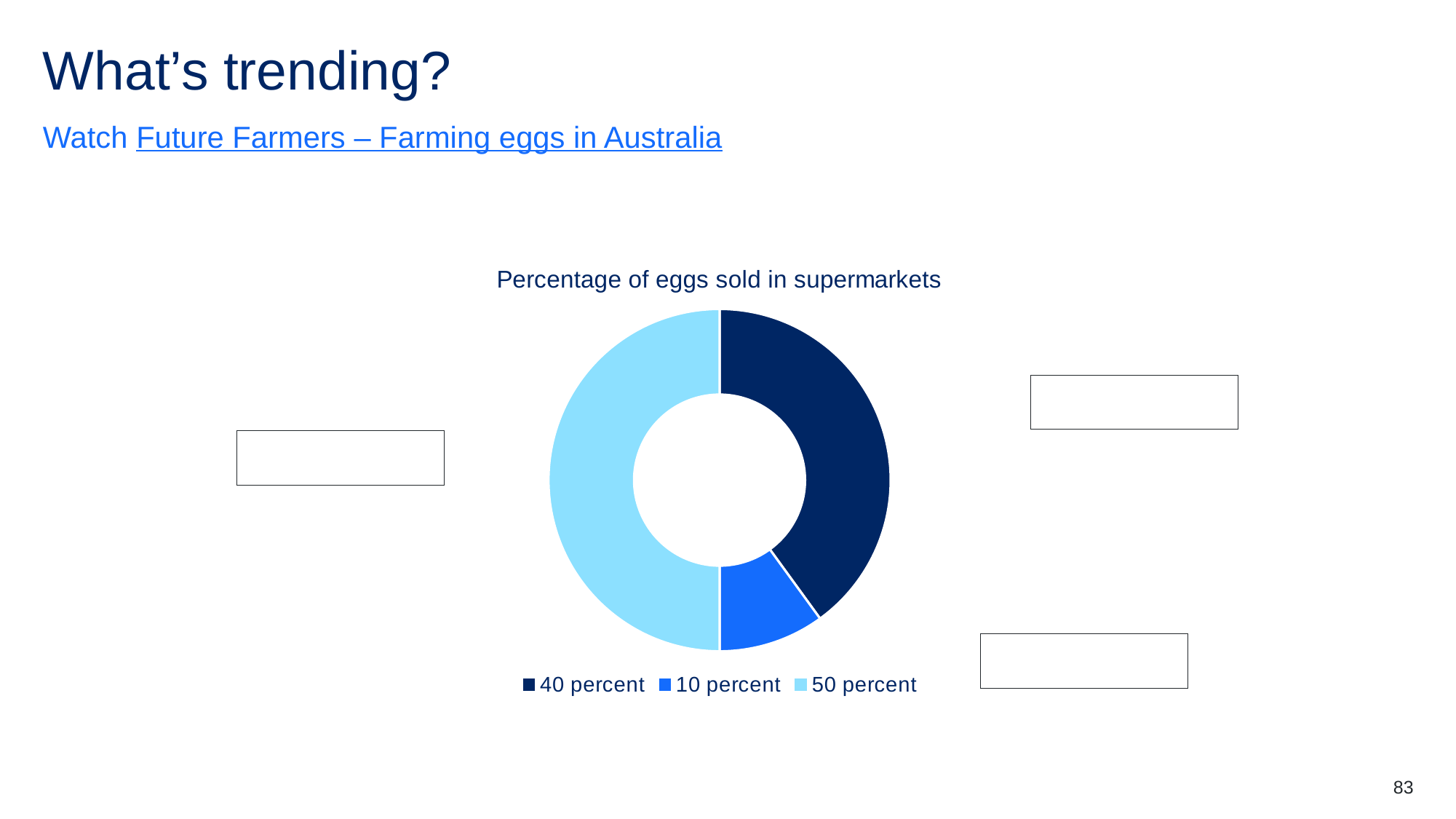
Which legend entry corresponds to the smallest slice of the chart? 10 percent How many entries does the chart's legend list? 3 What is the title of the chart? Percentage of eggs sold in supermarkets Is the slice labelled '10 percent' greater or less than a quarter of the chart? less How many slices does the chart have? 3 Which slice is larger: the one labelled '50 percent' or the one labelled '40 percent'? 50 percent What colour is the slice labelled '10 percent' in the legend? Medium (bright) blue What type of chart is shown on the slide? Doughnut (pie) chart Which slice is larger: the one labelled '40 percent' or the one labelled '10 percent'? 40 percent What share of the chart does the dark navy slice represent, according to the legend? 40 percent Which legend entry corresponds to the largest slice of the chart? 50 percent What share of the chart does the light blue slice represent, according to the legend? 50 percent